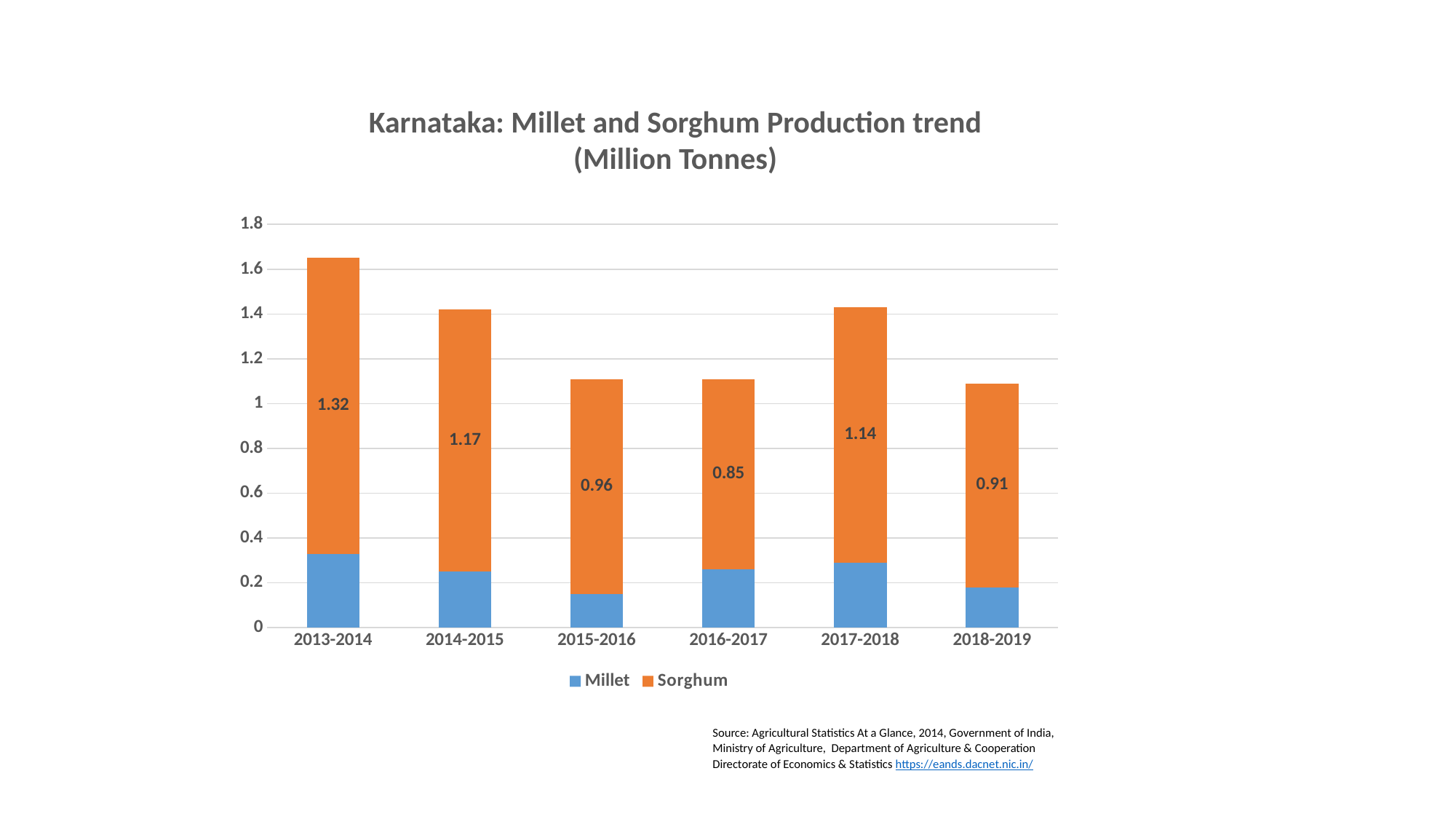
How many years are shown on the x axis? 6 Which year has the lowest Sorghum production? 2016-2017 How many series does the legend list? 2 What is the Sorghum production value for 2016-2017? 0.85 What is the difference between Sorghum production in 2013-2014 and 2014-2015? 0.15 What is the Sorghum production value for 2018-2019? 0.91 Is the Millet value for 2013-2014 greater or less than 0.2? greater Which year has higher Sorghum production, 2015-2016 or 2017-2018? 2017-2018 What is the Sorghum production value for 2013-2014? 1.32 Is the Millet value for 2015-2016 greater or less than 0.2? less Which year has the highest Sorghum production? 2013-2014 What kind of chart is shown on the slide? Stacked bar chart